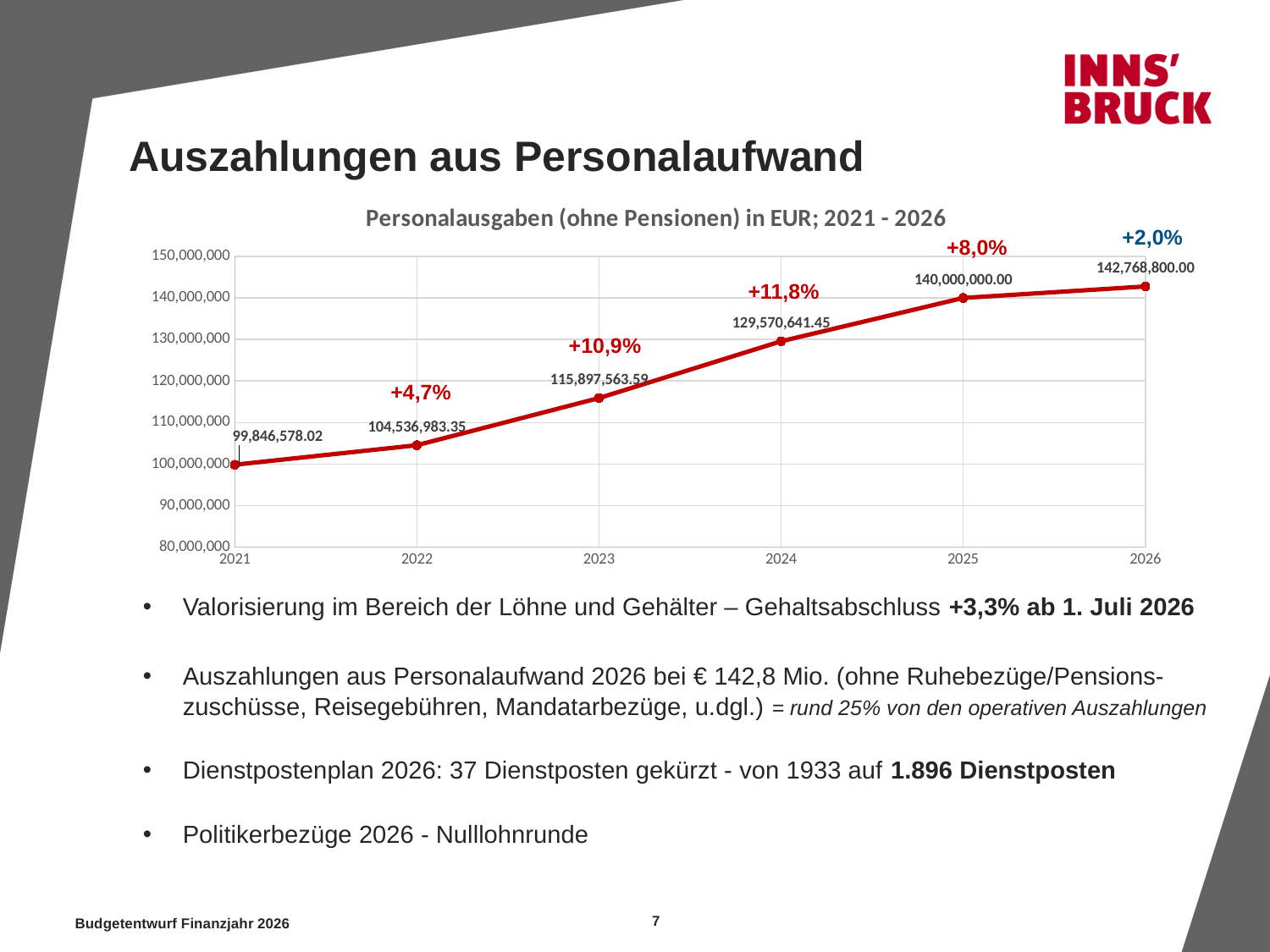
What kind of chart is shown? line chart What is the value for 2024? 129,570,641.45 How many years are plotted on the chart? 6 Which is larger, the value for 2023 or the value for 2022? 2023 What percentage change is annotated between 2023 and 2024? +11,8% Is the value for 2023 greater or less than 110,000,000? greater What is the difference between the values for 2026 and 2025? 2,768,800.00 What is the value for 2021? 99,846,578.02 What is the difference between the values for 2025 and 2024? 10,429,358.55 Which year has the lowest value? 2021 What is the value for 2026? 142,768,800.00 Which year has the highest value? 2026